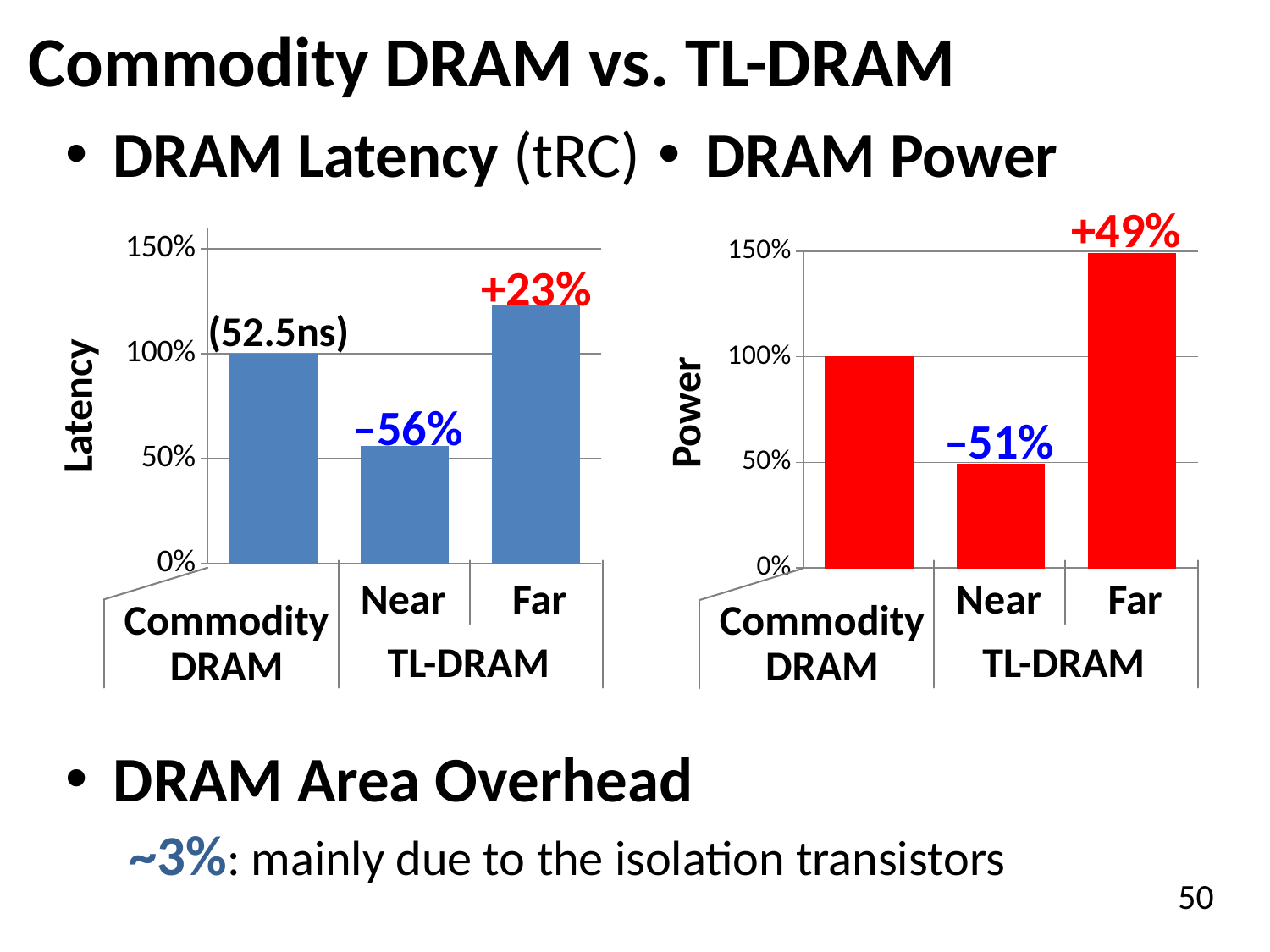
In the DRAM Latency chart, what change is labeled above the TL-DRAM Far bar? +23% In the DRAM Power chart, what change is labeled above the TL-DRAM Far bar? +49% What kind of chart is the DRAM Latency chart? Bar chart In the DRAM Latency chart, which bar is the lowest? Near (TL-DRAM) In the DRAM Latency chart, what change is labeled above the TL-DRAM Near bar? –56% In the DRAM Power chart, which bar is the highest? Far (TL-DRAM) In the DRAM Latency chart, is the value for TL-DRAM Near greater or less than 100%? less In the DRAM Power chart, is the value for TL-DRAM Far greater or less than 100%? greater How many bars are plotted in the DRAM Power chart? 3 In the DRAM Latency chart, what is the value for Commodity DRAM? 100% In the DRAM Power chart, what change is labeled above the TL-DRAM Near bar? –51% In the DRAM Latency chart, which bar is the highest? Far (TL-DRAM)